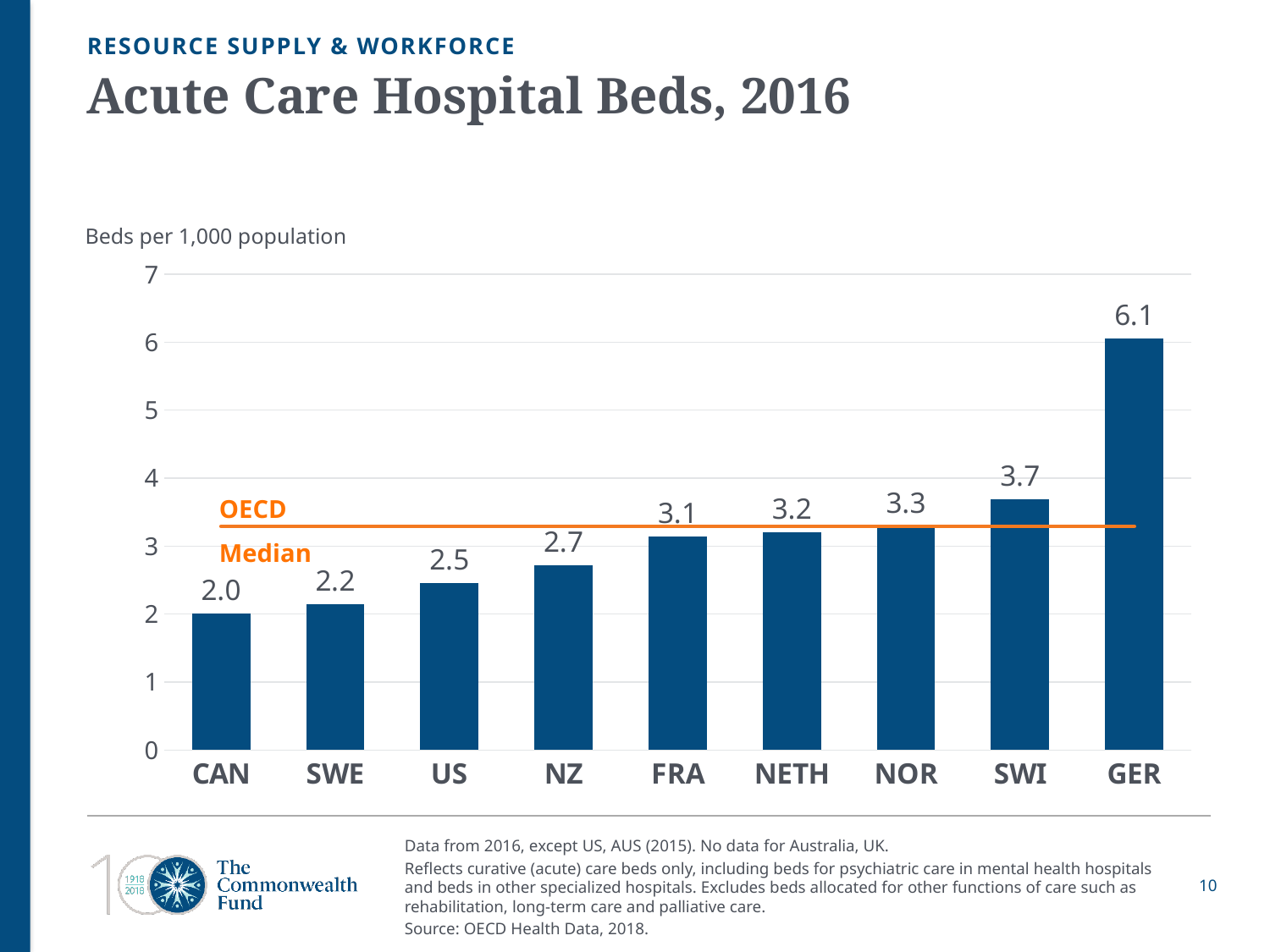
Which is larger, the value for FRA or the value for SWE? FRA What kind of chart is shown on the slide? bar chart What is the value for NETH? 3.2 What is the value for US? 2.5 What is the difference between the values for SWI and NZ? 1.0 What is the difference between the values for GER and CAN? 4.1 Is the value for NOR greater or less than 3? greater How many countries are shown in the chart? 9 What does the orange horizontal line on the chart represent? OECD Median What is the value for GER? 6.1 Which country has the lowest number of acute care hospital beds per 1,000 population? CAN Which country has the highest number of acute care hospital beds per 1,000 population? GER